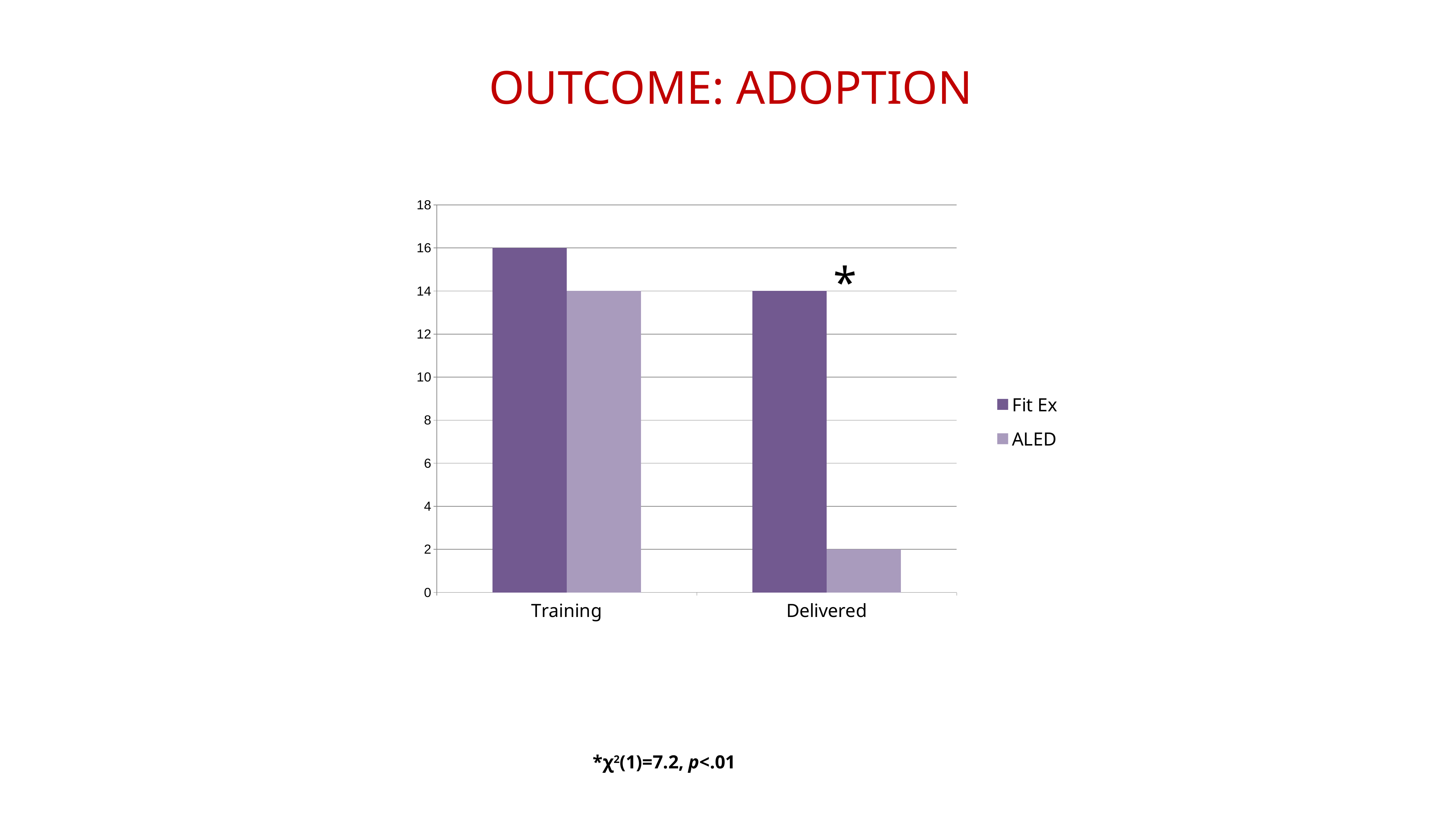
What is the value of the Fit Ex bar for Training? 16 What is the title of the slide? OUTCOME: ADOPTION What is the value of the ALED bar for Training? 14 Which is larger for Training, Fit Ex or ALED? Fit Ex What is the difference between the Fit Ex and ALED values for Delivered? 12 What is the value of the Fit Ex bar for Delivered? 14 What kind of chart is shown on the slide? Bar chart How many categories are shown on the x axis? 2 Which bar is the lowest in the chart? ALED, Delivered Which bar is the highest in the chart? Fit Ex, Training How many series does the legend list? 2 What is the value of the ALED bar for Delivered? 2